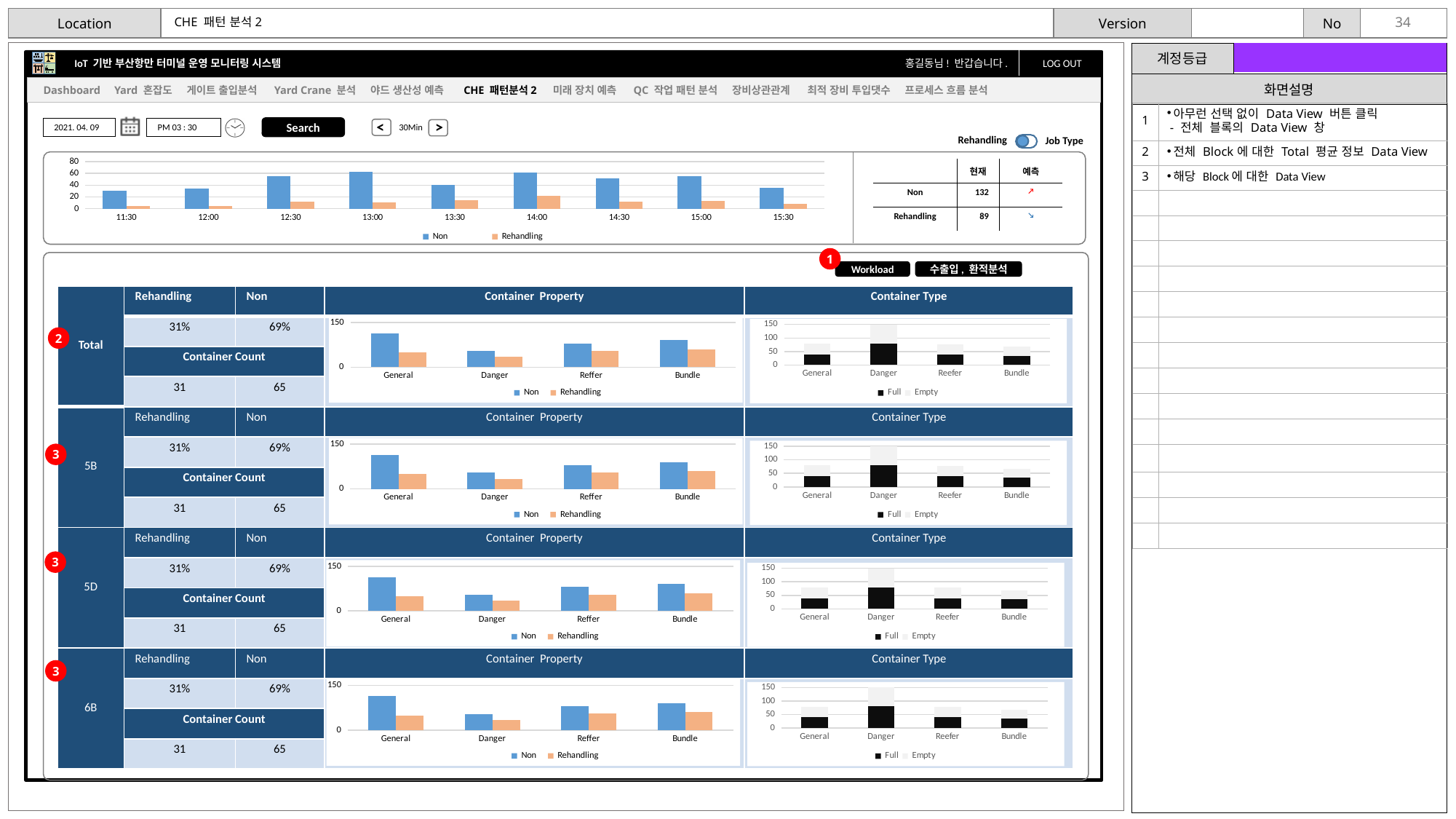
In the Container Type chart of the Total row, which category has the highest Full value? Danger In the top time-series chart, how many time points are shown on the x axis? 9 In the Container Type chart of the Total row, is the Empty value for Danger greater or less than 100? less In the Container Property chart of the Total row, which category has the lowest Non value? Danger In the top time-series chart, is the Non value at 13:00 greater or less than 40? greater In the top time-series chart, which is larger at 12:30, Non or Rehandling? Non What kind of chart is the Container Property chart in the Total row? bar chart In the top time-series chart, at which time is the Rehandling value highest? 14:00 In the top time-series chart, how many series does the legend list? 2 In the Container Property chart of the Total row, which category has the highest Non value? General In the Container Type chart of the 5B row, what are the two series listed in the legend? Full, Empty In the top time-series chart, is the Rehandling value at 14:00 greater or less than 40? less